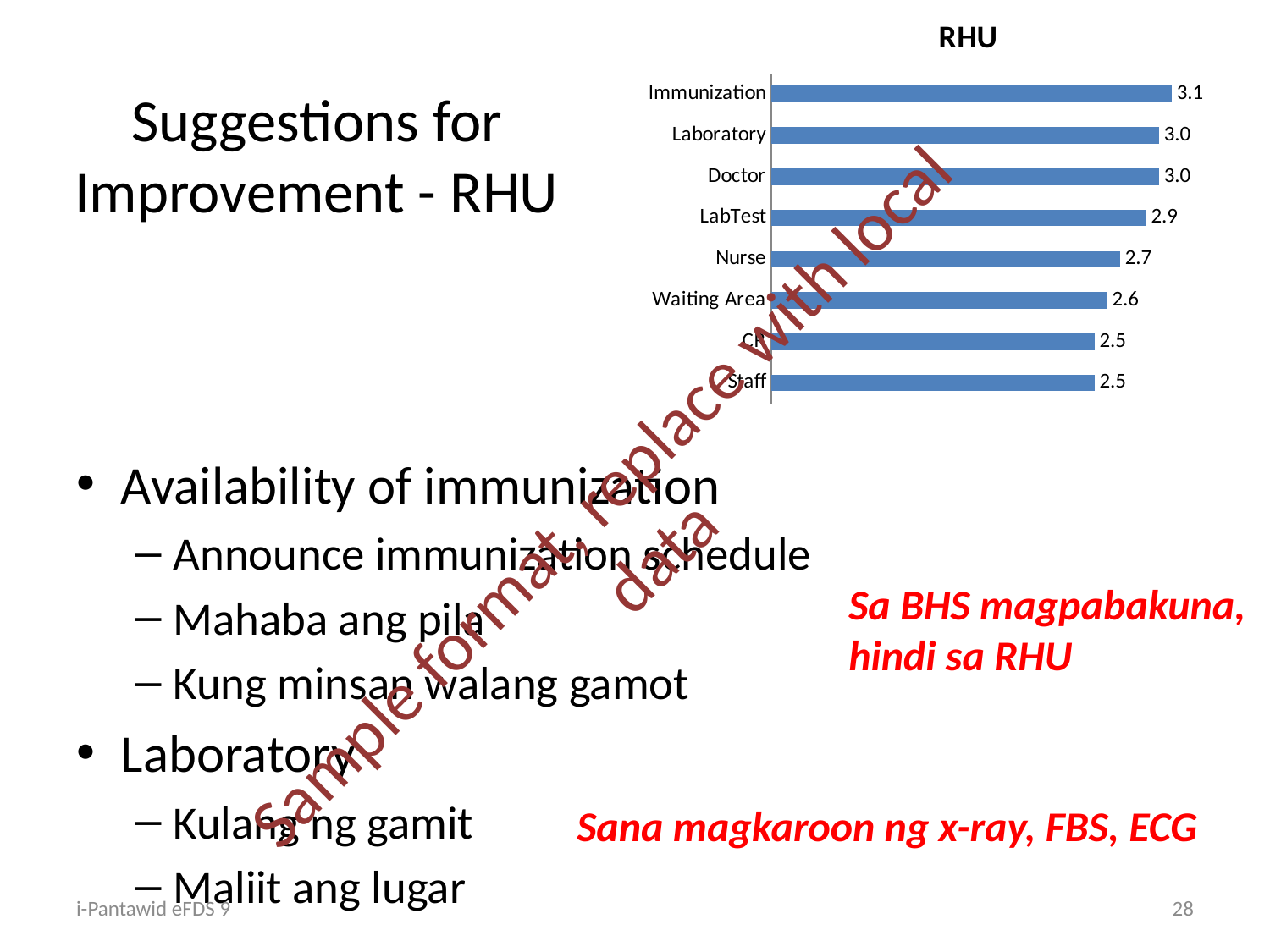
What is the difference between the values for Laboratory and Nurse? 0.3 How many categories (bars) are shown in the chart? 8 What is the value for Immunization? 3.1 Which has a larger value, Doctor or LabTest? Doctor What is the value for Waiting Area? 2.6 What type of chart is shown on the slide? bar chart What is the difference between the values for Immunization and Staff? 0.6 What is the value for LabTest? 2.9 What is the title of the chart? RHU Which category has the highest value? Immunization What is the value for Nurse? 2.7 What is the value for Staff? 2.5